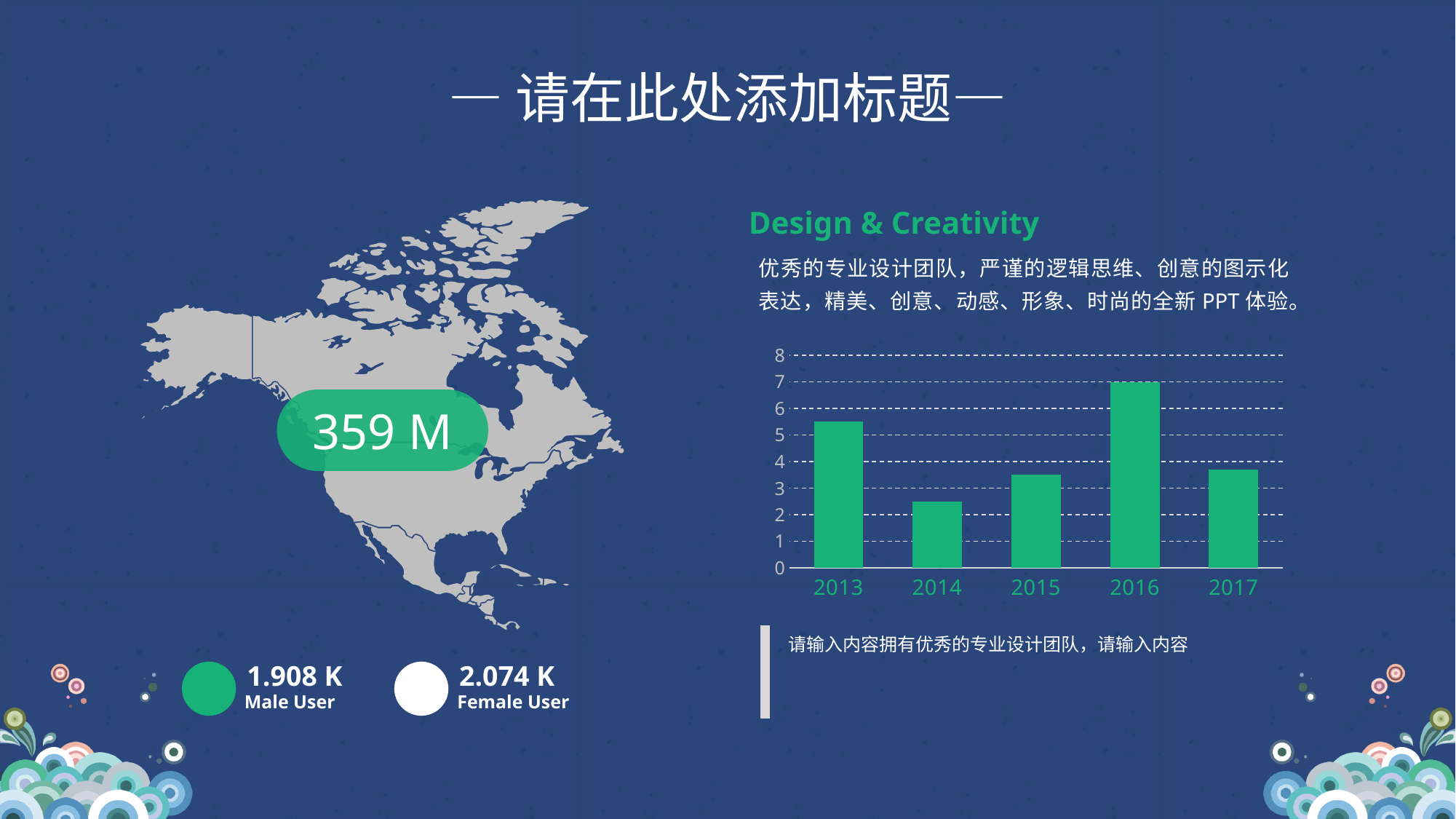
Which year has the lowest bar in the chart? 2014 Is the value for 2015 greater or less than 3? greater Which year has the highest bar in the chart? 2016 What kind of chart is shown on the right side of the slide? bar chart Is the value for 2014 greater or less than 3? less How many years are shown on the x axis of the bar chart? 5 Is the value for 2017 greater or less than 4? less Does the value rise or fall from 2013 to 2014? fall What is the highest value shown on the y axis of the bar chart? 8 What is the value of the bar for 2016? 7 Which is larger, the bar for 2013 or the bar for 2015? 2013